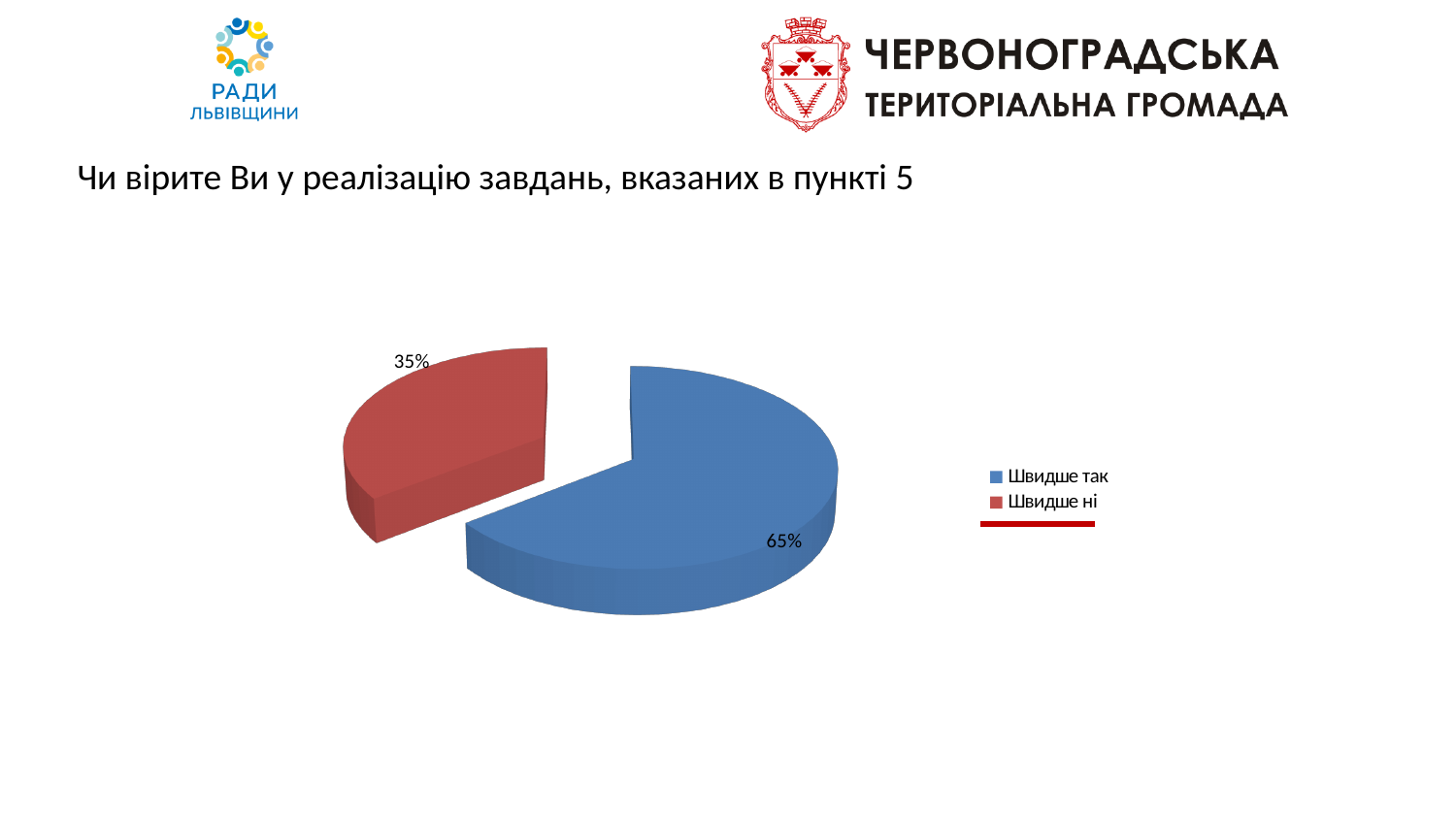
What share of the pie does "Швидше так" represent? 65% What colour is the slice for "Швидше ні"? Red What share of the pie does "Швидше ні" represent? 35% Which category has the largest slice of the pie? Швидше так How many entries does the legend list? 2 Which is larger, the slice for "Швидше так" or the slice for "Швидше ні"? Швидше так What kind of chart is shown on the slide? Pie chart How many slices does the pie chart have? 2 Which category has the smallest slice of the pie? Швидше ні What is the difference in percentage points between "Швидше так" and "Швидше ні"? 30 What question is the chart on the slide about? Чи вірите Ви у реалізацію завдань, вказаних в пункті 5